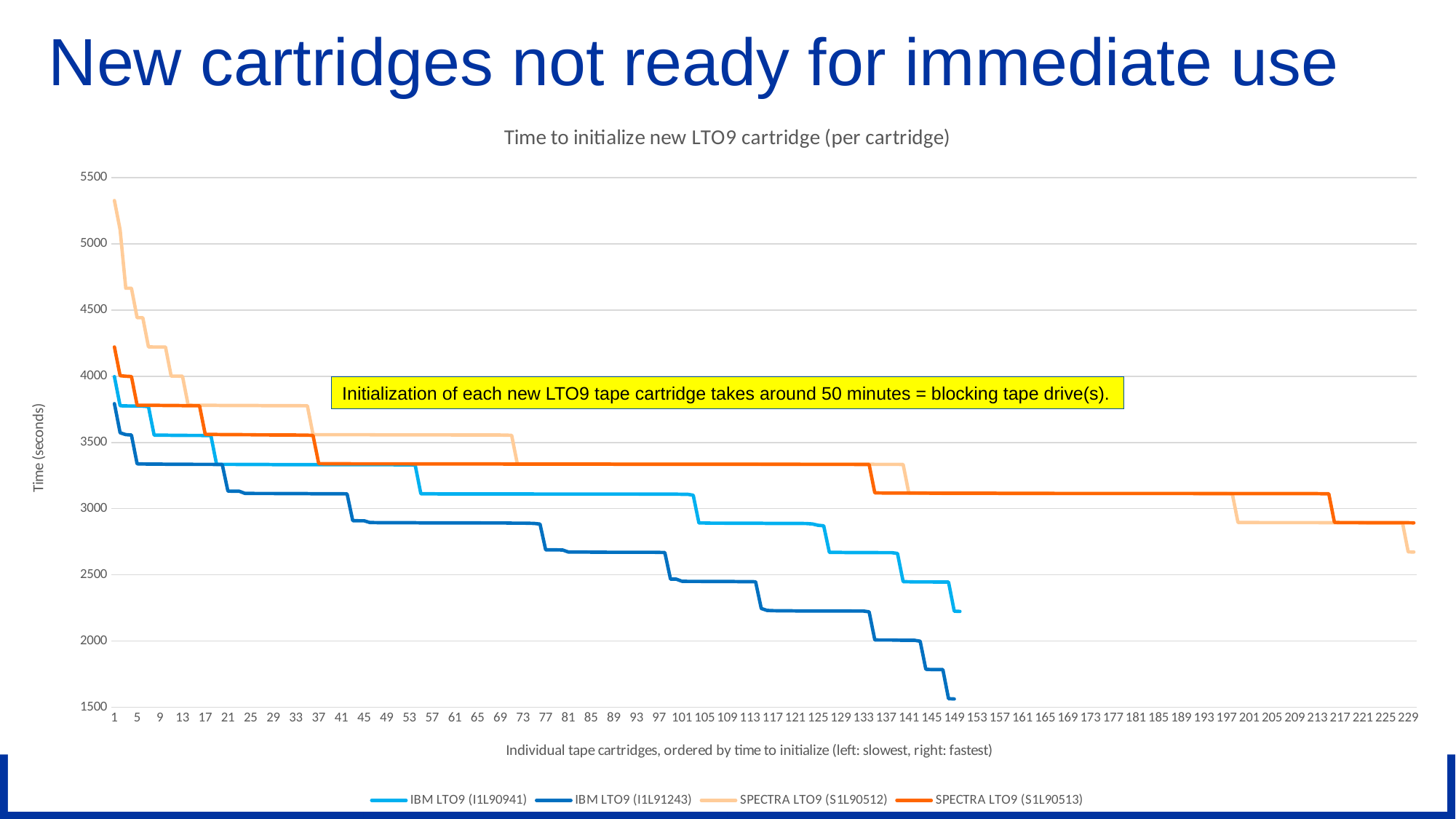
Is the value for SPECTRA LTO9 (S1L90513) at cartridge 101 greater or less than 3000? greater What kind of chart is shown on the slide? line chart At cartridge 1, which series has the higher value, SPECTRA LTO9 (S1L90512) or IBM LTO9 (I1L90941)? SPECTRA LTO9 (S1L90512) Is the lowest value of IBM LTO9 (I1L91243) greater or less than 2000? less What is the label of the vertical axis? Time (seconds) Is the value for the first cartridge of IBM LTO9 (I1L91243) greater or less than 4000? less How many series does the legend list? 4 Which series reaches the highest value on the chart? SPECTRA LTO9 (S1L90512) Which series reaches the lowest value on the chart? IBM LTO9 (I1L91243) What is the title of the chart? Time to initialize new LTO9 cartridge (per cartridge) Do the values rise or fall from left to right along the x axis? fall